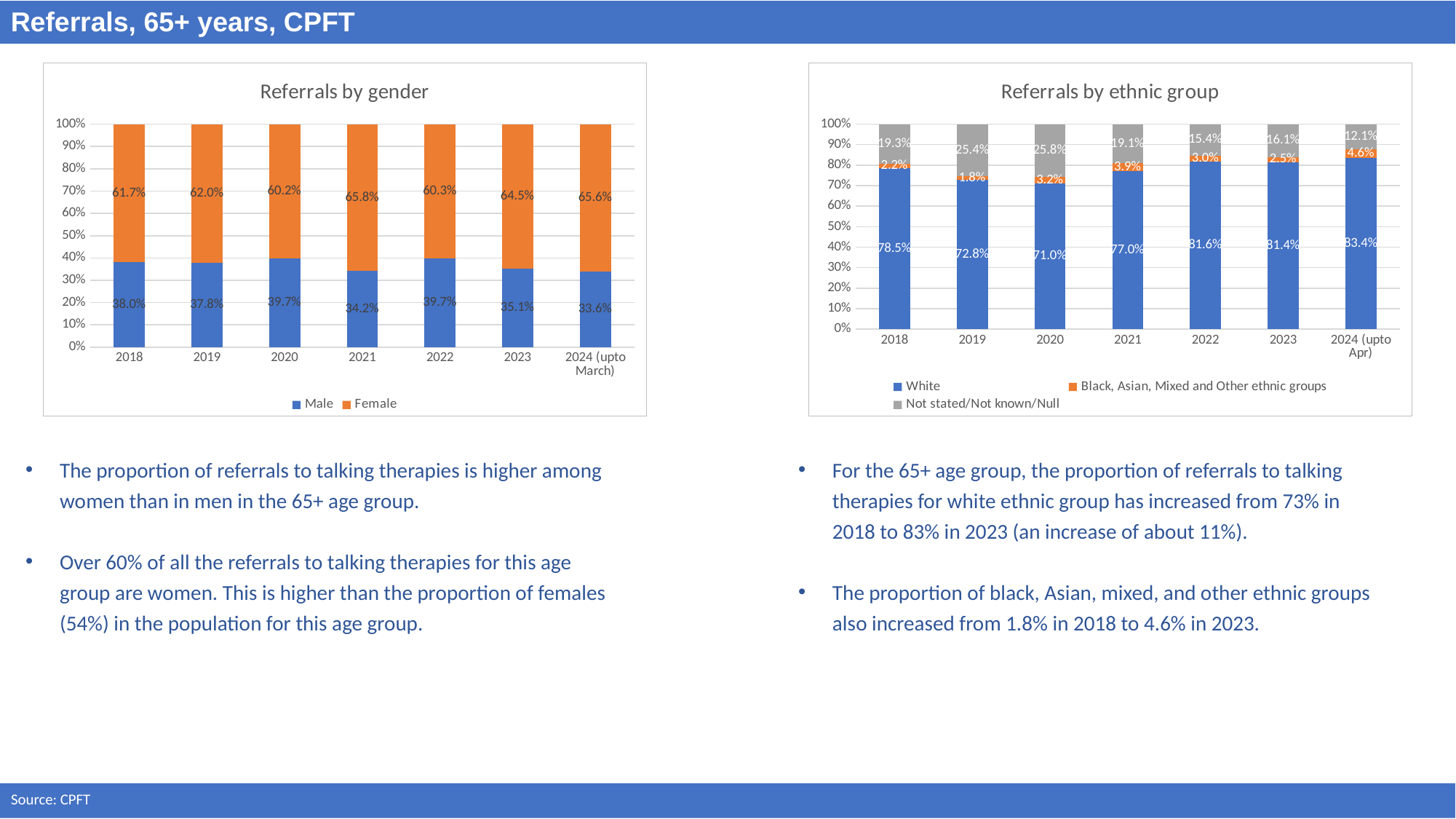
In the 'Referrals by ethnic group' chart, how many years are shown on the x axis? 7 In the 'Referrals by ethnic group' chart, what is the White value for 2020? 71.0% What kind of chart is 'Referrals by ethnic group'? Stacked bar chart In the 'Referrals by ethnic group' chart, which year has the highest value for Black, Asian, Mixed and Other ethnic groups? 2024 (upto Apr) In the 'Referrals by gender' chart, which year has the lowest Male proportion? 2024 (upto March) In the 'Referrals by gender' chart, how many series does the legend list? 2 In the 'Referrals by gender' chart, which year has the highest Male proportion? 2020 and 2022 (39.7%) In the 'Referrals by gender' chart, what is the Female value for 2021? 65.8% In the 'Referrals by ethnic group' chart, what is the Not stated/Not known/Null value for 2019? 25.4% In the 'Referrals by gender' chart, what is the Male value for 2024 (upto March)? 33.6% In the 'Referrals by gender' chart, what is the difference between the Female and Male values in 2018? 23.7% In the 'Referrals by ethnic group' chart, is the White value larger in 2022 or in 2021? 2022